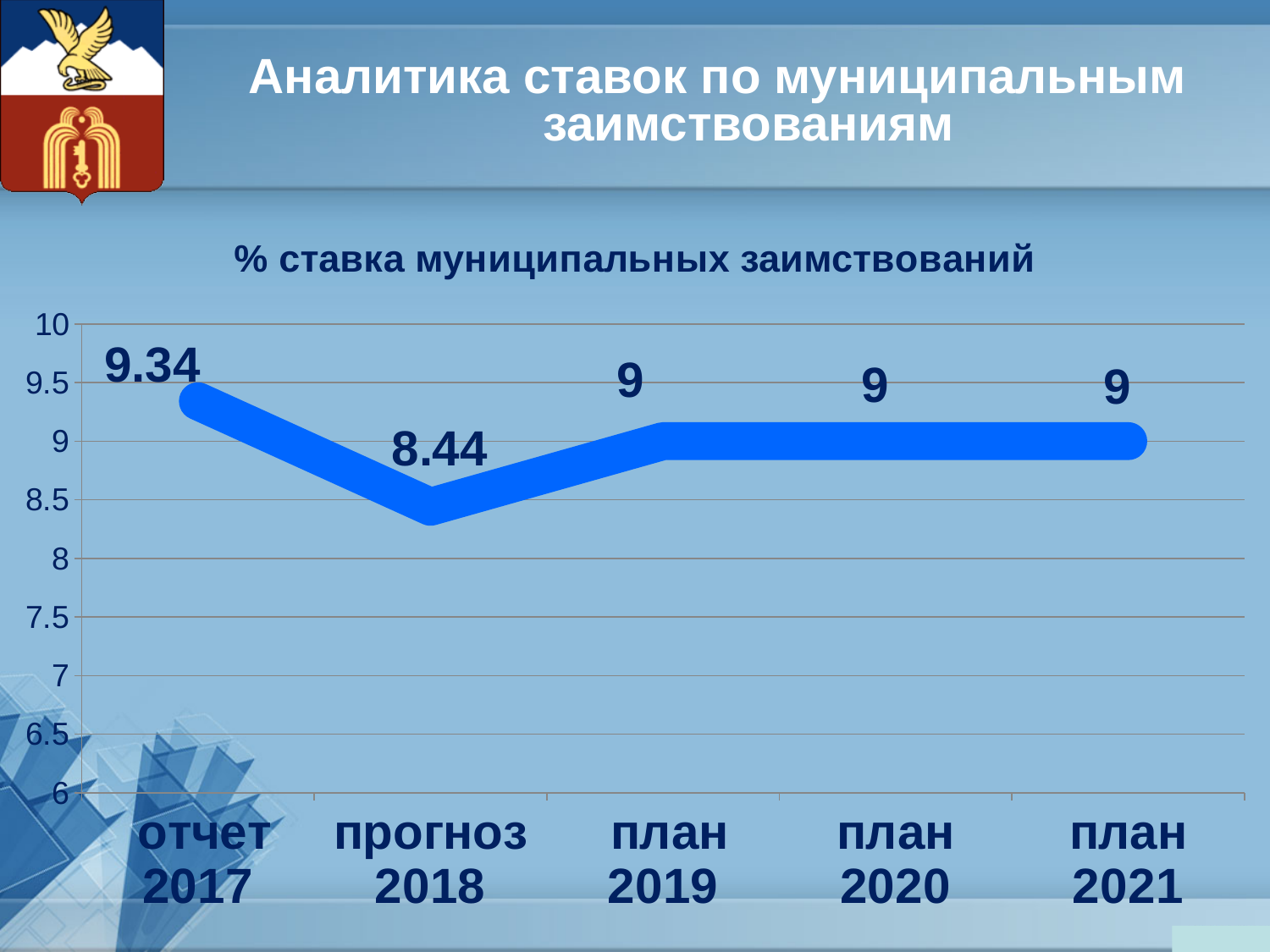
How many categories are shown on the x axis? 5 Which is larger, the value for прогноз 2018 or the value for план 2020? план 2020 What kind of chart is shown on the slide? line chart What is the value for план 2019? 9 What is the difference between the values for отчет 2017 and прогноз 2018? 0.9 Which category has the highest value? отчет 2017 Which category has the lowest value? прогноз 2018 What is the title of the chart? % ставка муниципальных заимствований Is the value for прогноз 2018 greater or less than 8.5? less What is the value for прогноз 2018? 8.44 What is the value for план 2021? 9 What is the value for отчет 2017? 9.34